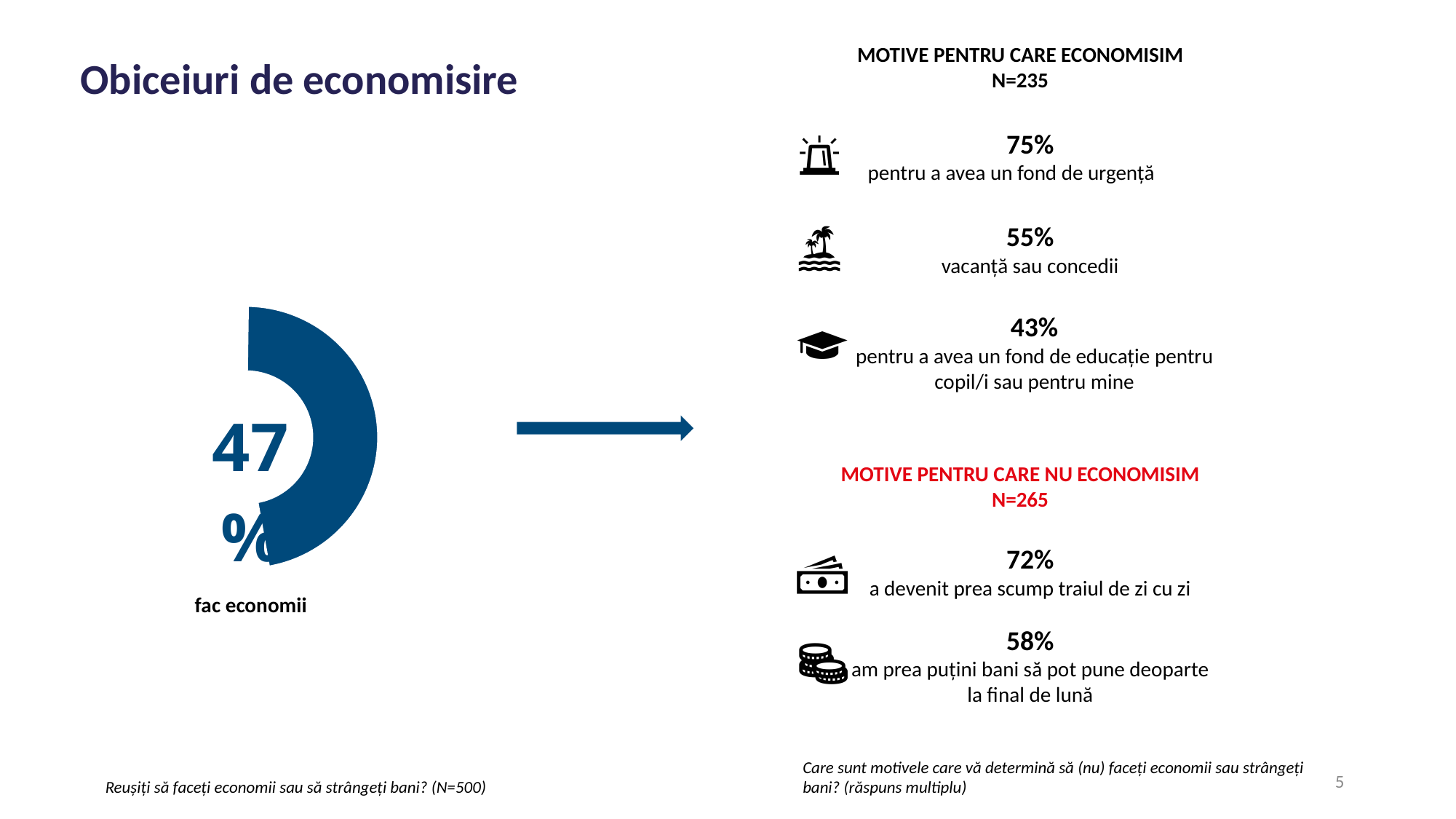
What share of the doughnut chart does the filled segment labelled 'fac economii' represent? 47% What type of chart is shown on the left of the slide? doughnut chart What label appears beneath the doughnut chart? fac economii What is the sample size (N) stated for the question answered by the doughnut chart? N=500 What percentage is shown in the centre of the doughnut chart? 47% Is the value shown in the doughnut chart greater or less than 50%? less Does the filled segment of the doughnut chart cover more or less than half of the ring? less